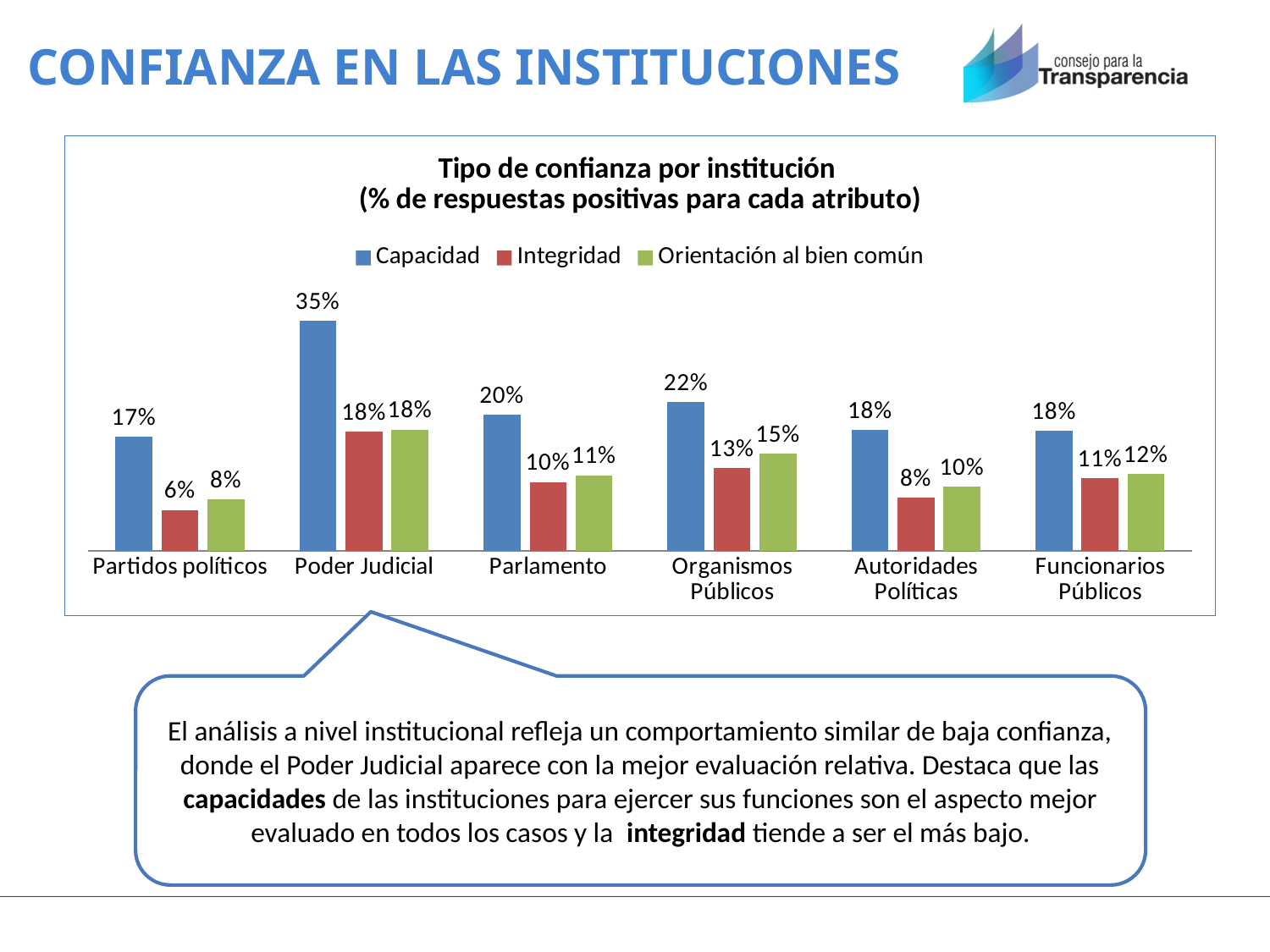
How many series does the legend list? 3 What is the title of the chart? Tipo de confianza por institución (% de respuestas positivas para cada atributo) What kind of chart is shown? Bar chart Which institution has the lowest Integridad value? Partidos políticos Which is larger: the Orientación al bien común value for Autoridades Políticas or for Funcionarios Públicos? Funcionarios Públicos Which institution has the highest Capacidad value? Poder Judicial Which colour represents the Integridad series? Red What is the Integridad value for Partidos políticos? 6% What is the Orientación al bien común value for Organismos Públicos? 15% What is the Capacidad value for Poder Judicial? 35% How many institutions are shown on the x axis? 6 What is the difference between the Capacidad and Integridad values for Parlamento? 10%